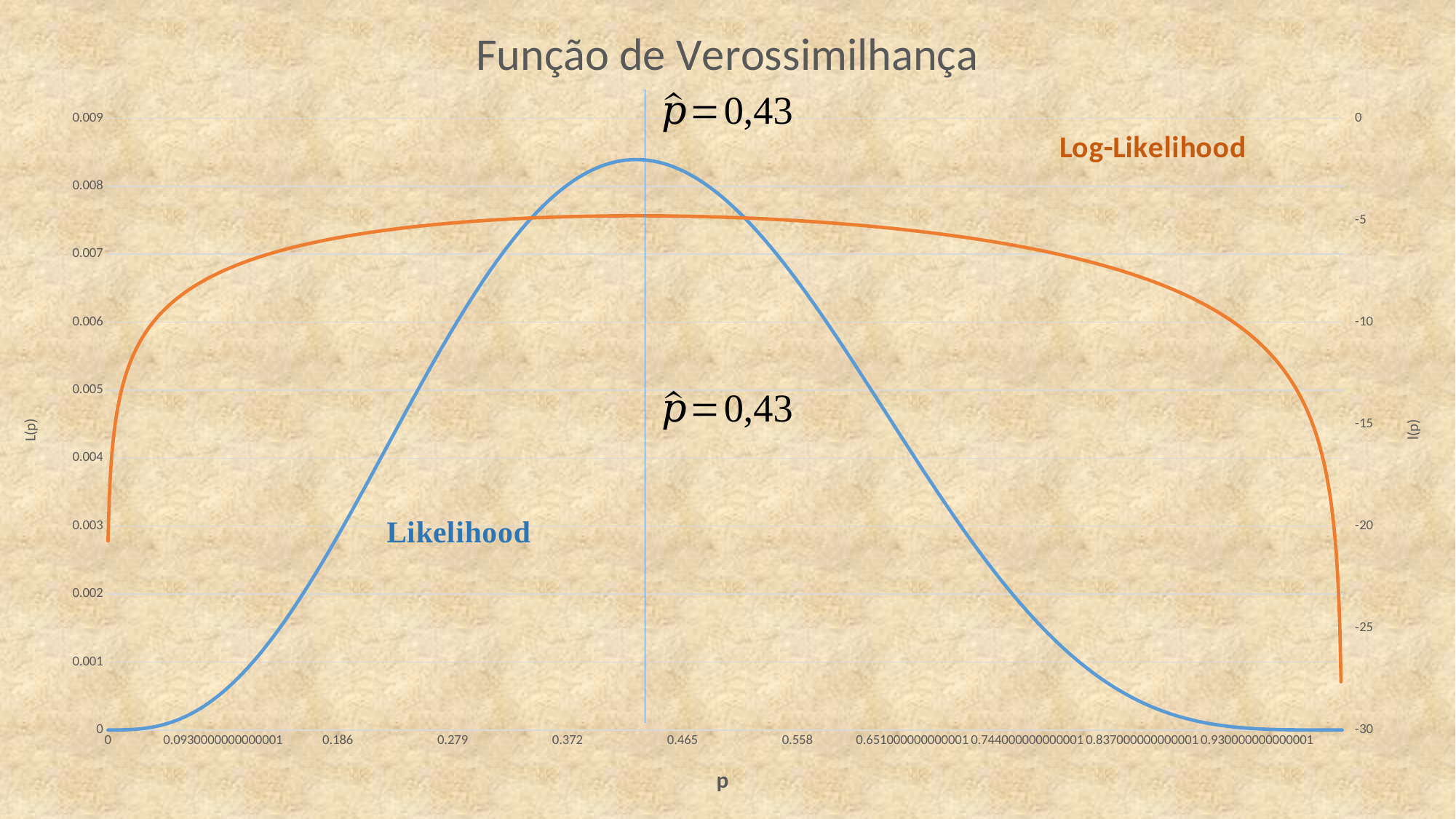
What value of p̂ is annotated on the chart? 0,43 Is the peak value of the Likelihood curve greater or less than 0.008? greater How many series are plotted on the chart? 2 Is the value of the Log-Likelihood curve at p = 0 greater or less than -15? less Is the value of the Likelihood curve at p = 0.837 greater or less than 0.002? less What kind of chart is shown on the slide? line chart Does the Likelihood curve rise or fall as p increases from 0.558 to 0.930? fall Does the Likelihood curve rise or fall as p increases from 0 to 0.372? rise Which series is drawn in orange? Log-Likelihood What is the title of the chart? Função de Verossimilhança